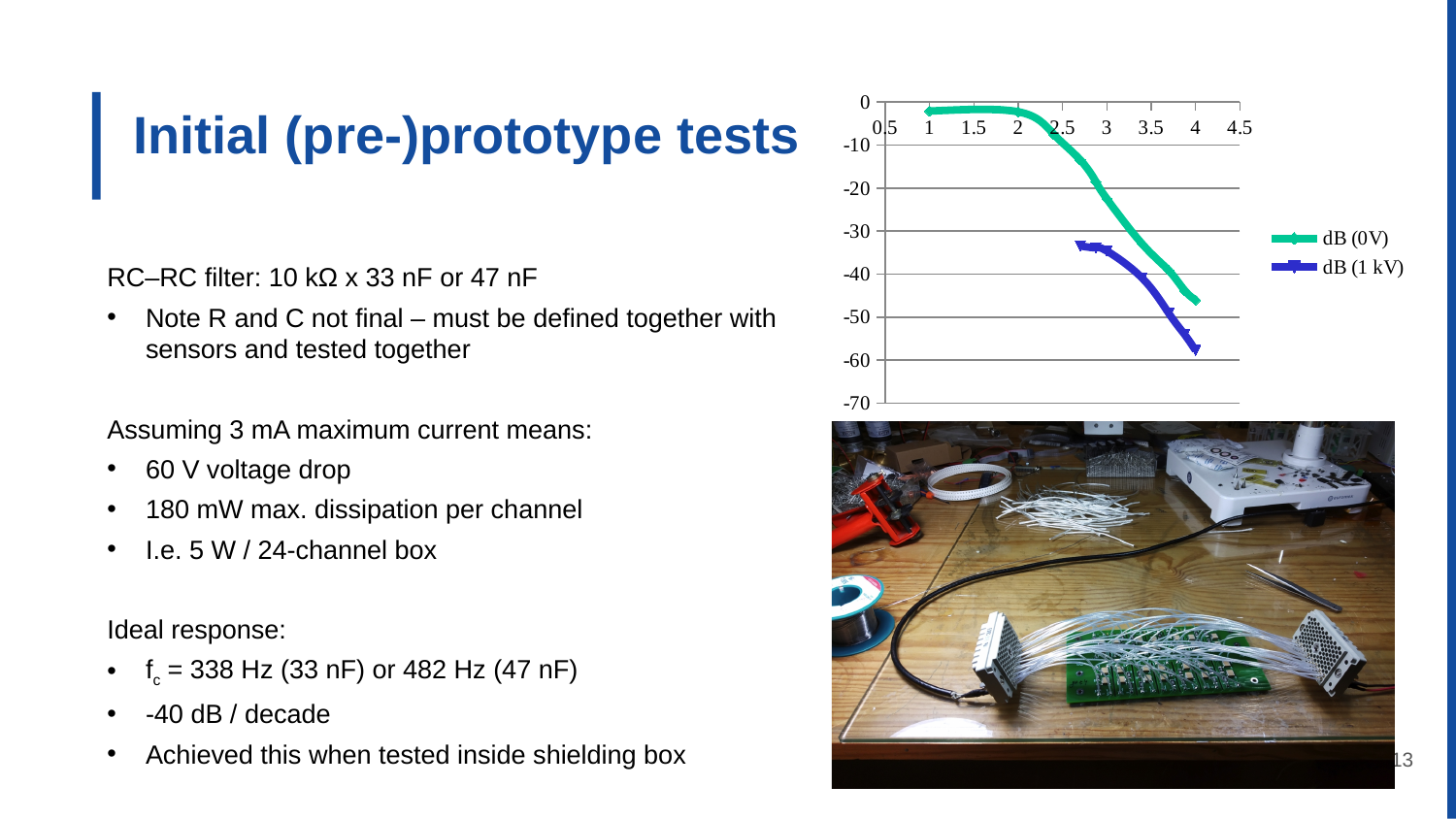
Is the value of the dB (1 kV) series at x = 3 greater or less than -30? less How many series does the legend of the chart list? 2 Is the value of the dB (0V) series at x = 4 greater or less than -40? less What kind of chart is shown at the top right of the slide? line chart What is the lowest value shown on the y-axis of the chart? -70 Does the dB (0V) series rise or fall as the x-axis value increases? fall What are the two series named in the chart legend? dB (0V) and dB (1 kV) Is the value of the dB (0V) series at x = 1 greater or less than -10? greater At x = 4, which series has the higher (less negative) value, dB (0V) or dB (1 kV)? dB (0V) Which colour is used for the dB (1 kV) series in the chart? blue Does the dB (1 kV) series rise or fall as the x-axis value increases? fall